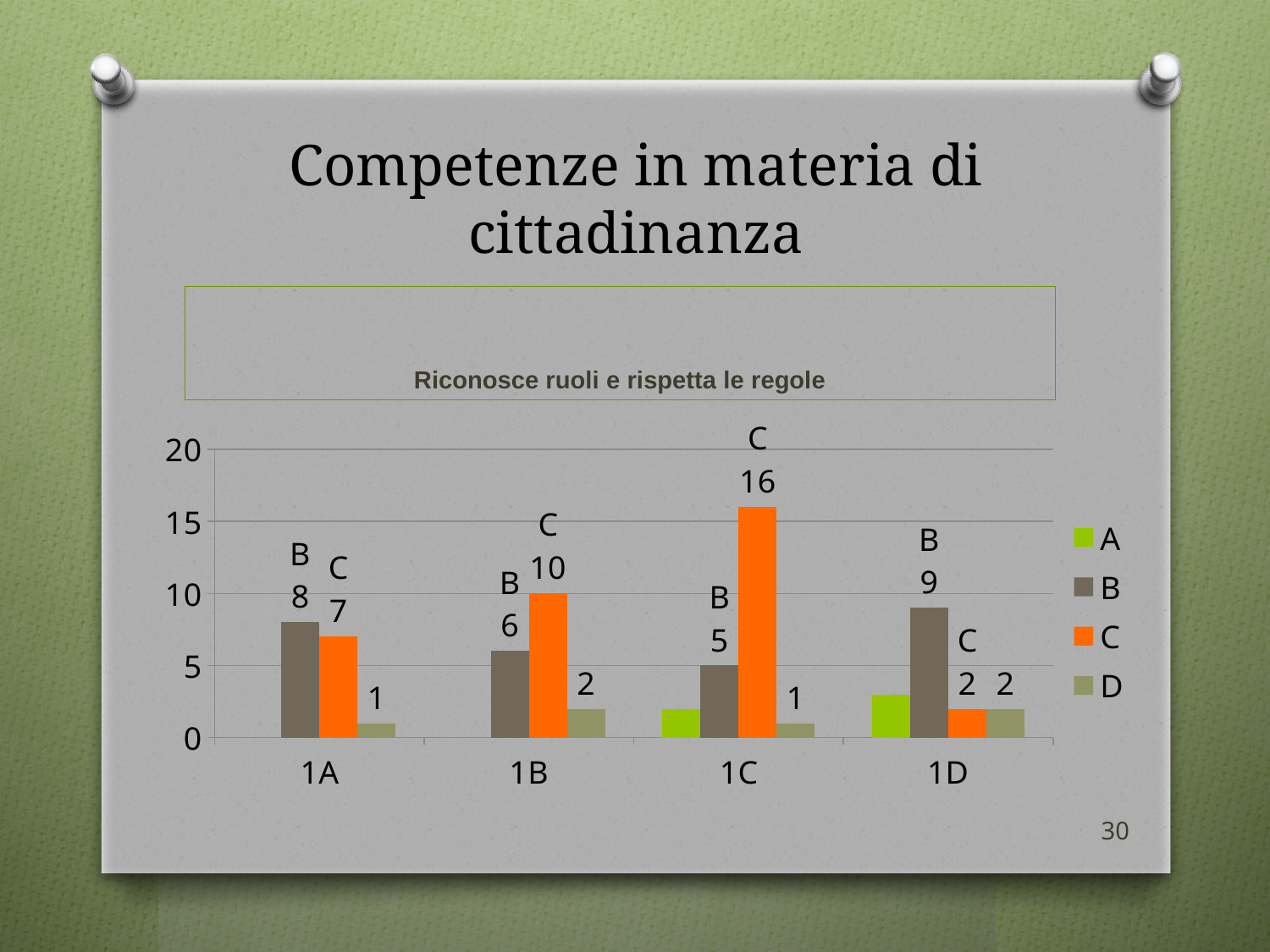
Is the value of series C for class 1C greater or less than 15? greater Which class has the highest value for series C? 1C How many classes are shown on the x axis? 4 What is the difference between the series C value for 1C and the series C value for 1B? 6 How many series does the legend list? 4 Which class has the larger series B value, 1A or 1B? 1A What is the value of series D for class 1B? 2 What kind of chart is shown on the slide? bar chart What is the title of the chart? Riconosce ruoli e rispetta le regole Which class has the lowest value for series B? 1C What is the value of series B for class 1D? 9 What is the value of series C for class 1C? 16